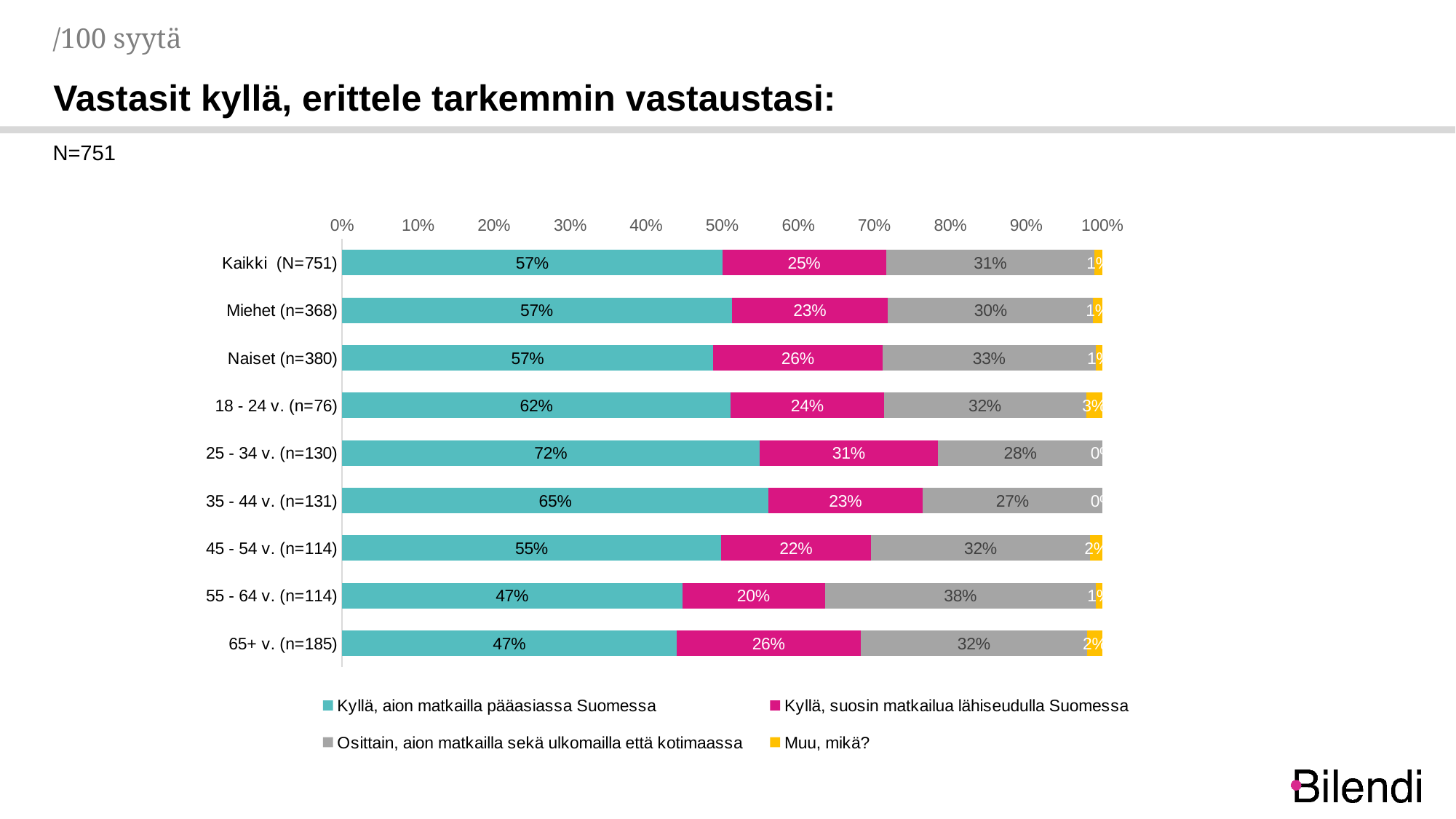
What is the value for "Kyllä, suosin matkailua lähiseudulla Suomessa" in the 25 - 34 v. (n=130) row? 31% Which category has the highest value for "Kyllä, aion matkailla pääasiassa Suomessa"? 25 - 34 v. (n=130) What is the value for "Muu, mikä?" in the 18 - 24 v. (n=76) row? 3% How many categories (rows) are shown in the chart? 9 What is the value for "Kyllä, aion matkailla pääasiassa Suomessa" in the Kaikki (N=751) row? 57% What is the value for "Osittain, aion matkailla sekä ulkomailla että kotimaassa" in the 55 - 64 v. (n=114) row? 38% Which has a larger value for "Osittain, aion matkailla sekä ulkomailla että kotimaassa": Miehet (n=368) or Naiset (n=380)? Naiset (n=380) What kind of chart is shown on the slide? Stacked bar chart What is the difference in "Kyllä, aion matkailla pääasiassa Suomessa" between 25 - 34 v. (n=130) and 55 - 64 v. (n=114)? 25 percentage points Which category has the highest value for "Osittain, aion matkailla sekä ulkomailla että kotimaassa"? 55 - 64 v. (n=114) How many series does the legend list? 4 Which category has the lowest value for "Kyllä, suosin matkailua lähiseudulla Suomessa"? 55 - 64 v. (n=114)